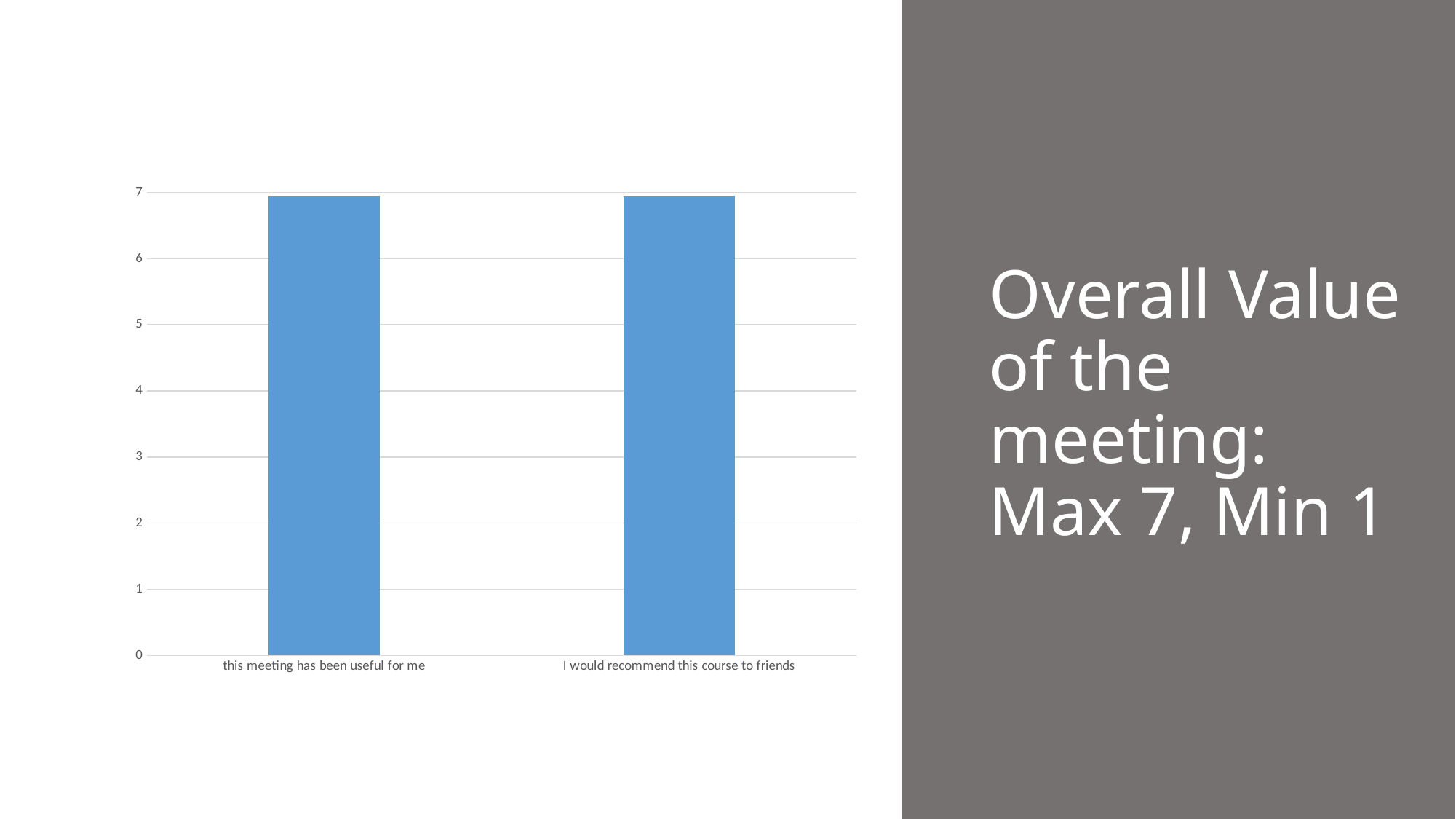
What is the highest value shown on the vertical axis of the chart? 7 Is the value for "I would recommend this course to friends" greater or less than 6? greater What colour are the bars in the chart? blue Is the value for "this meeting has been useful for me" greater or less than 6? greater How many categories are plotted on the chart? 2 Is the value for "I would recommend this course to friends" greater or less than 4? greater What kind of chart is shown on the slide? bar chart